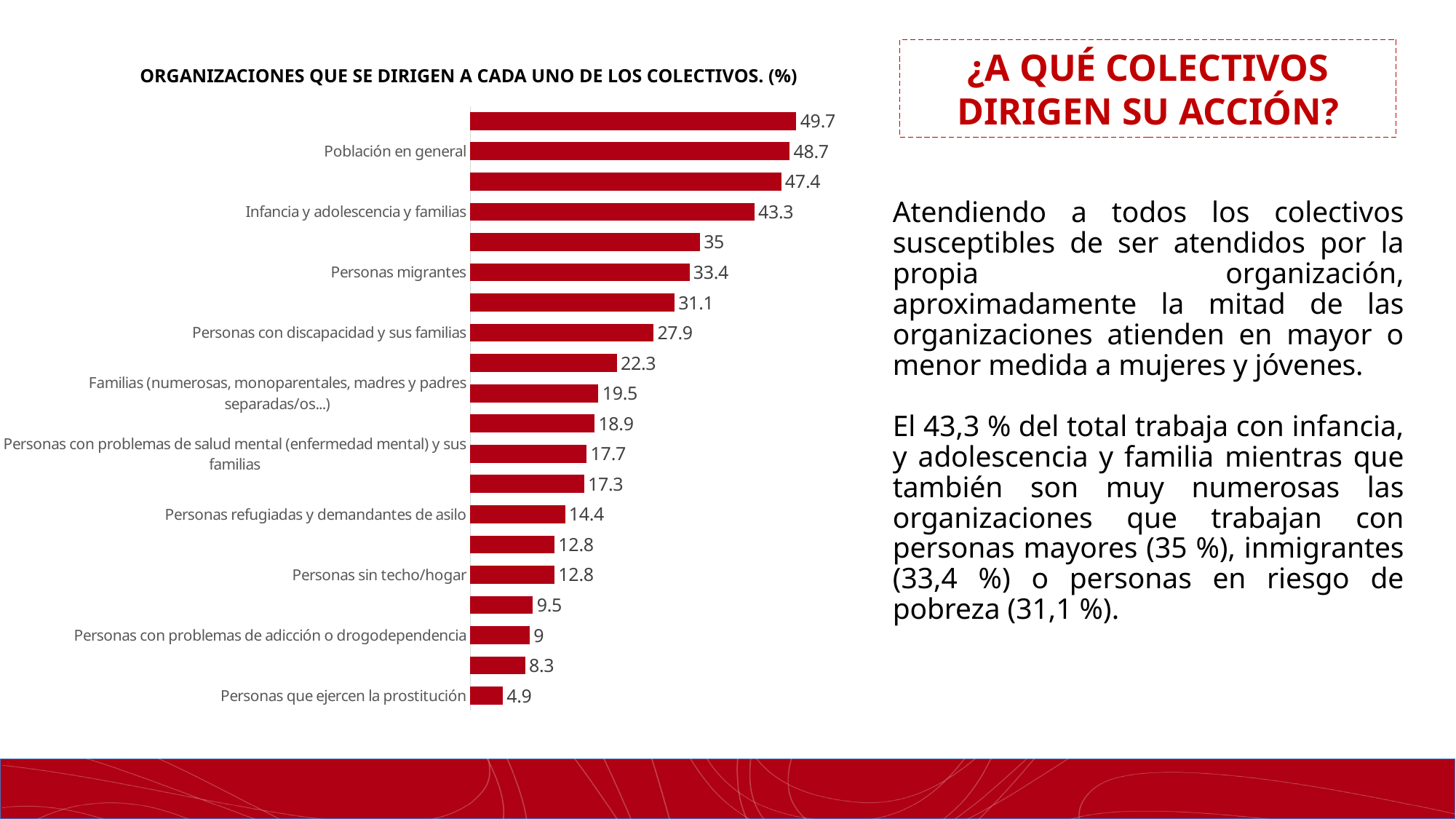
What is the value for Población en general? 48.7 How many bars are plotted in the chart? 20 What is the value for Infancia y adolescencia y familias? 43.3 What is the value for Personas refugiadas y demandantes de asilo? 14.4 What is the value for Personas con problemas de adicción o drogodependencia? 9 What is the difference between the values for Población en general and Infancia y adolescencia y familias? 5.4 What is the highest value shown in the chart? 49.7 What is the value for Personas migrantes? 33.4 What is the title of the chart? ORGANIZACIONES QUE SE DIRIGEN A CADA UNO DE LOS COLECTIVOS. (%) Which is larger, the value for Personas migrantes or the value for Personas con discapacidad y sus familias? Personas migrantes Which labelled category has the lowest value in the chart? Personas que ejercen la prostitución What type of chart is shown on the slide? Bar chart